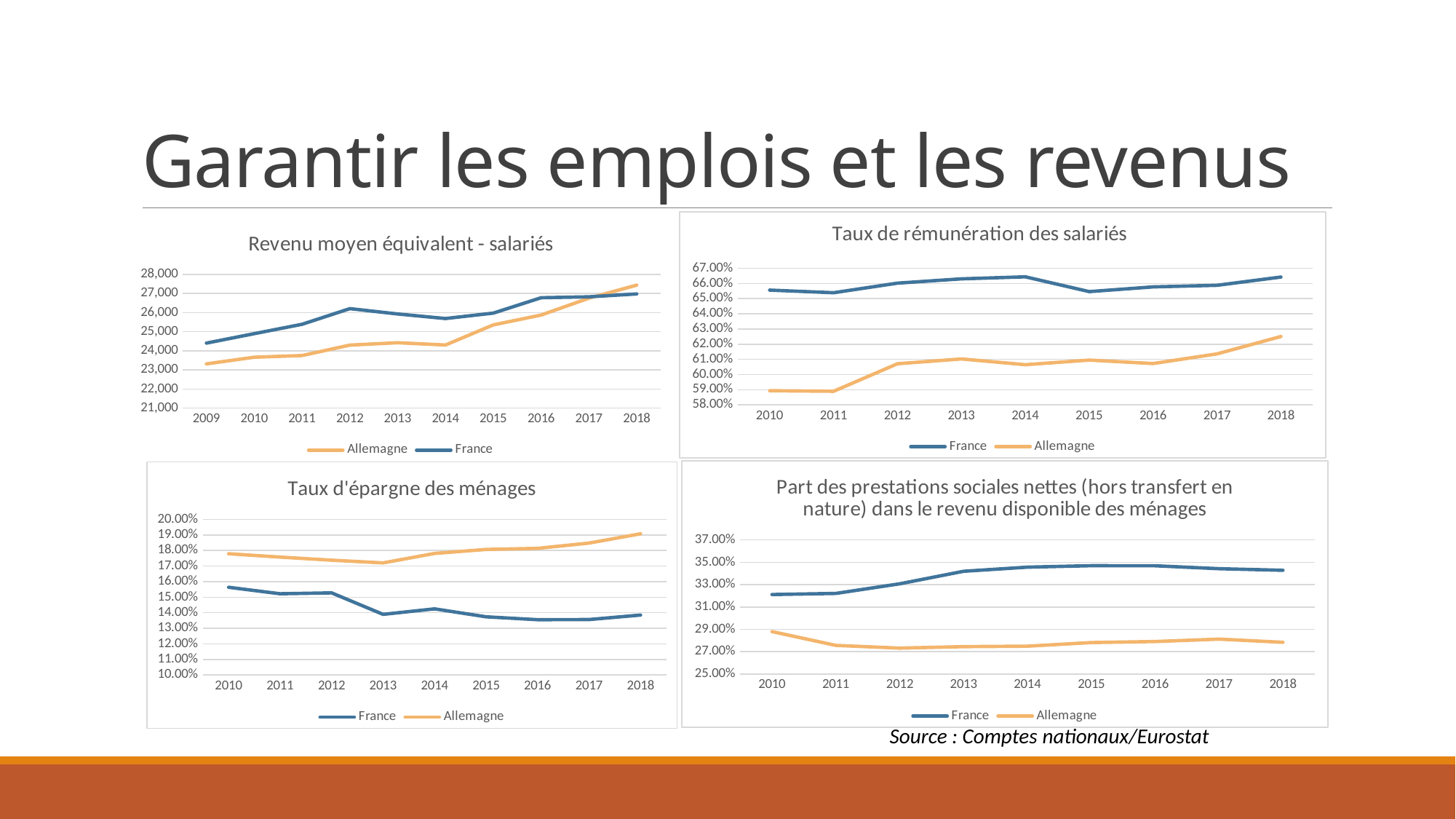
In the chart "Revenu moyen équivalent - salariés", which series is higher in 2018, Allemagne or France? Allemagne What type of chart is "Revenu moyen équivalent - salariés"? Line chart How many series does the legend of "Taux de rémunération des salariés" list? 2 In the chart "Taux de rémunération des salariés", is the value for Allemagne in 2010 greater or less than 60.00%? less In the chart "Taux d'épargne des ménages", is the value for France in 2010 greater or less than 15.00%? greater In the chart "Revenu moyen équivalent - salariés", is the value for Allemagne in 2009 greater or less than 24,000? less How many charts are shown on the slide? 4 In the chart "Part des prestations sociales nettes (hors transfert en nature) dans le revenu disponible des ménages", what colour is the Allemagne line? Orange In the chart "Taux d'épargne des ménages", does the France series rise or fall overall from 2010 to 2018? Fall In the chart "Taux de rémunération des salariés", which series is higher in 2018, France or Allemagne? France In the chart "Revenu moyen équivalent - salariés", how many years are plotted on the x axis? 10